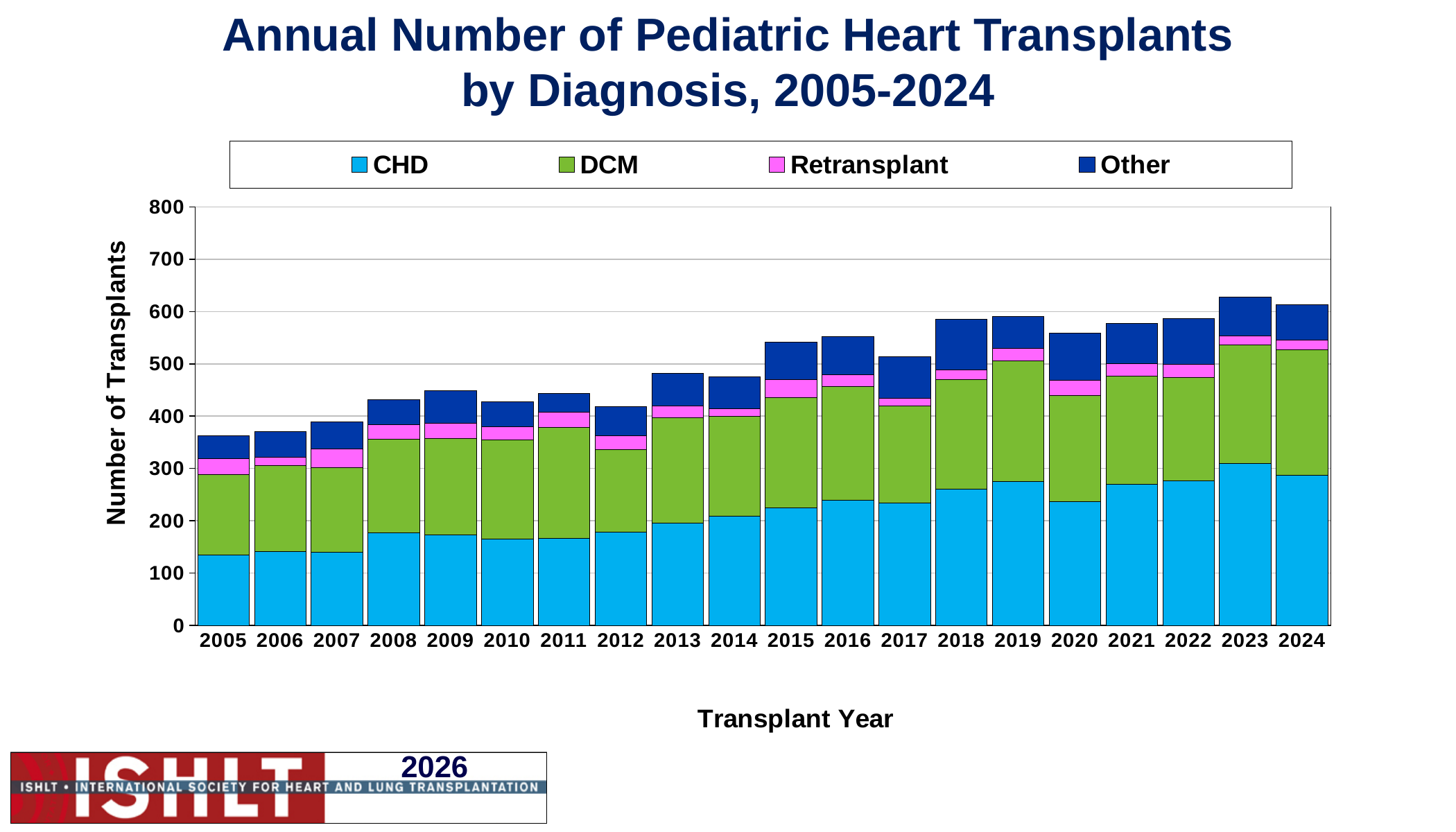
Is the CHD value for 2005 greater or less than 100? greater Which year has the larger CHD value, 2019 or 2020? 2019 Which year has the larger total number of transplants, 2005 or 2023? 2023 What is the title of the y axis? Number of Transplants Is the total number of transplants in 2015 greater or less than 500? greater How many transplant years are shown on the x axis? 20 Do the total annual transplant numbers generally rise or fall from 2005 to 2024? rise What kind of chart is shown on the slide? Stacked bar chart How many diagnosis series does the legend list? 4 Which diagnosis categories are listed in the legend? CHD, DCM, Retransplant, Other Is the total number of transplants in 2005 greater or less than 400? less